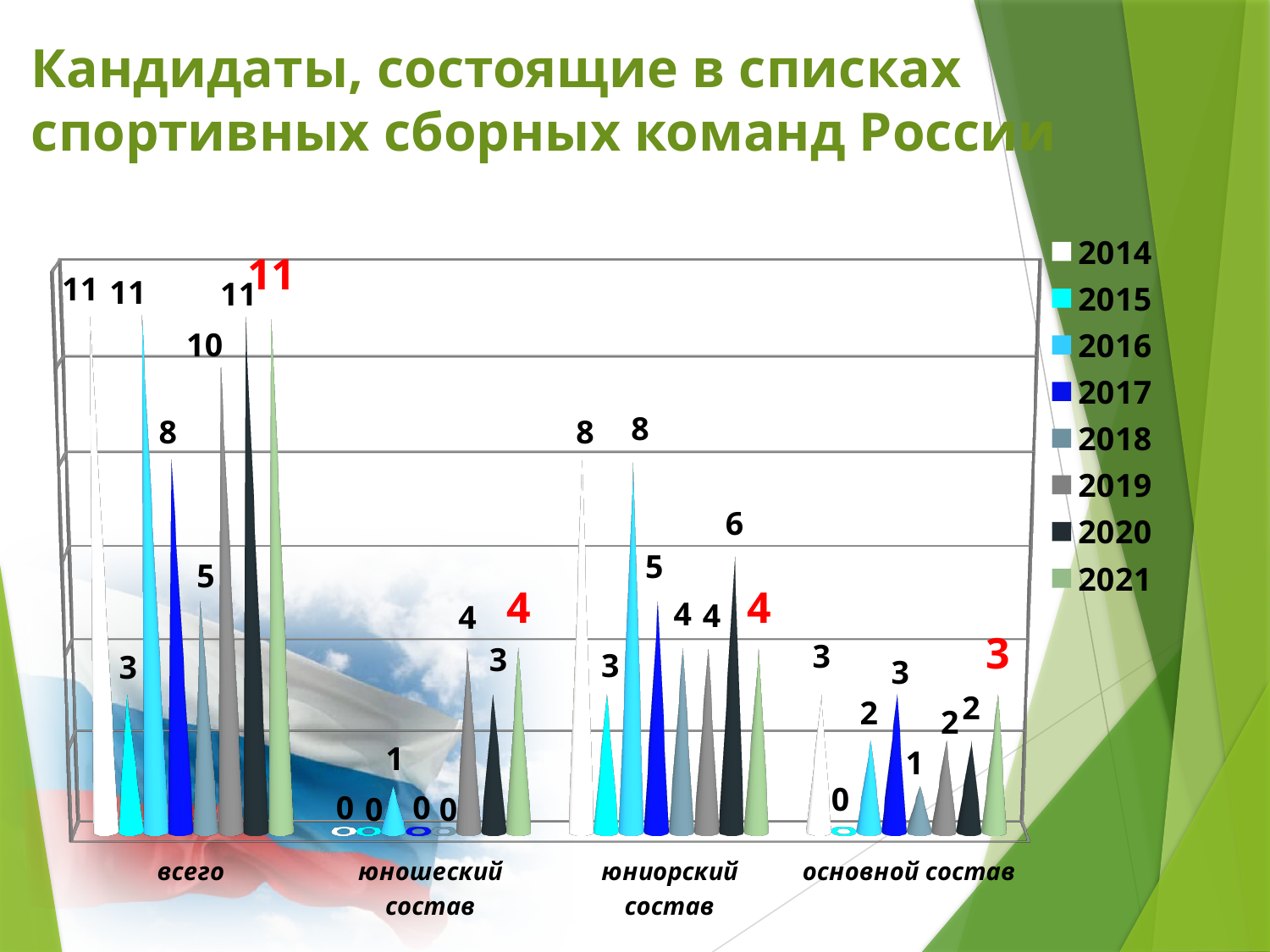
Which is larger in the "юниорский состав" category: the value for 2017 or the value for 2020? 2020 How many categories are shown on the x axis? 4 What kind of chart is shown on the slide? Bar chart What is the difference between the 2019 and 2018 values in the "всего" category? 5 What is the value for 2019 in the "юношеский состав" category? 4 Which year has the lowest value in the "всего" category? 2015 Which year has the highest value in the "юниорский состав" category? 2014 and 2016 (both 8) What is the title of the chart on the slide? Кандидаты, состоящие в списках спортивных сборных команд России How many series does the legend list? 8 What is the value for 2020 in the "юниорский состав" category? 6 What is the value for 2018 in the "основной состав" category? 1 What is the value for 2021 in the "всего" category? 11